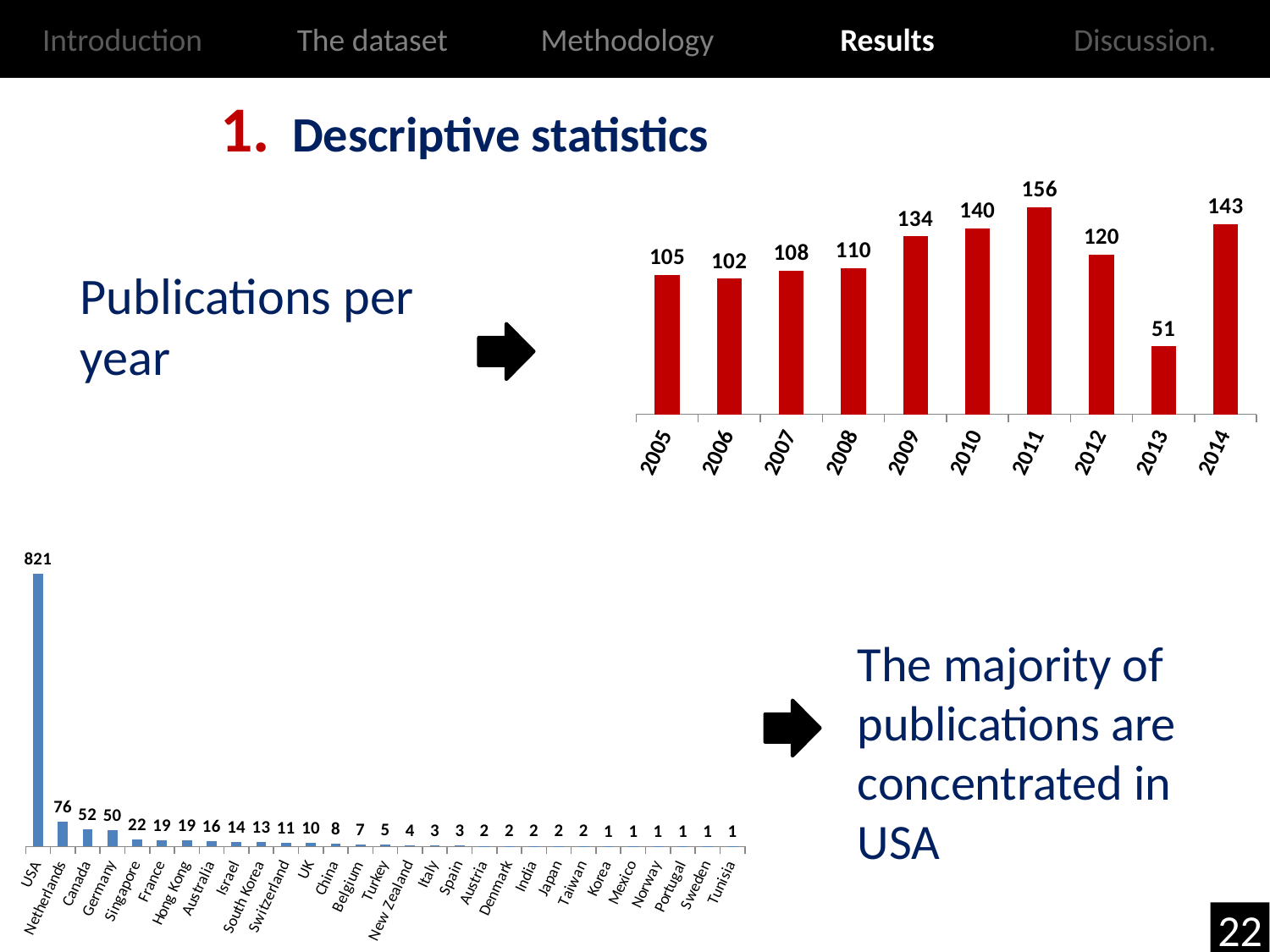
In the bottom-left chart of publications by country, how many countries are shown? 29 What kind of chart is the publications per year chart? Bar chart In the publications per year chart, how many years are shown? 10 In the publications per year chart, what is the difference between the 2014 and 2013 values? 92 In the bottom-left chart of publications by country, which country has the highest value? USA In the publications per year chart, which is larger, the value for 2009 or the value for 2012? 2009 In the publications per year chart, how many publications were there in 2011? 156 In the bottom-left chart of publications by country, how many publications does the USA have? 821 In the publications per year chart, which year has the lowest value? 2013 In the publications per year chart, which year has the highest value? 2011 In the bottom-left chart of publications by country, what is the difference between the values for Canada and Germany? 2 In the bottom-left chart of publications by country, what is the value for Netherlands? 76